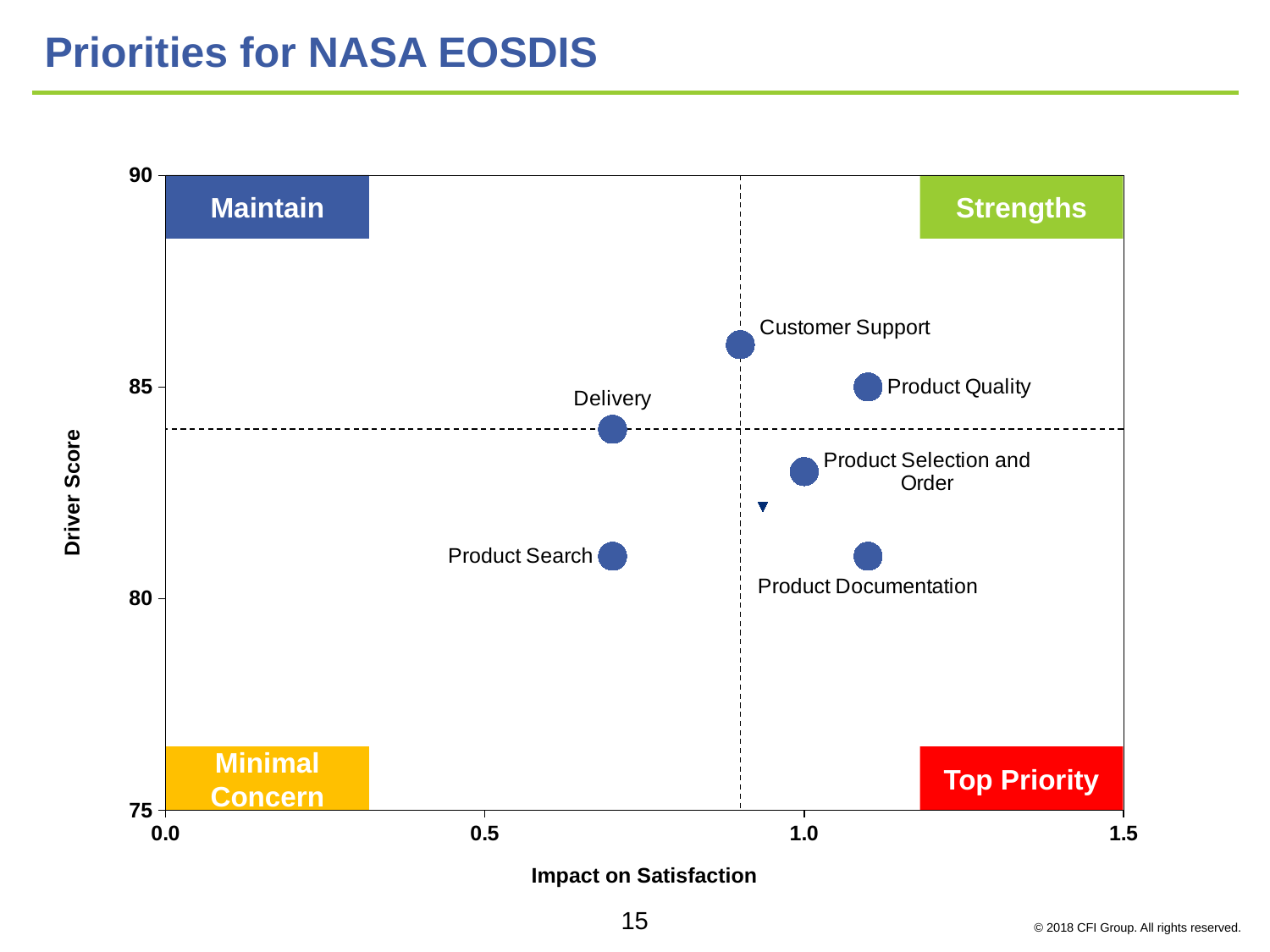
Is the Driver Score for Customer Support greater or less than 85? greater Which has a higher Impact on Satisfaction, Product Quality or Delivery? Product Quality How many labeled drivers are plotted on the chart? 6 Is the Driver Score for Product Search greater or less than 85? less What is the label on the x axis of the chart? Impact on Satisfaction What is the Driver Score for Product Quality? 85 Which has a higher Driver Score, Customer Support or Delivery? Customer Support What kind of chart is shown on the slide? Scatter chart Is the Impact on Satisfaction for Delivery greater or less than 1.0? less Which driver has the highest Driver Score? Customer Support What is the label of the quadrant in the bottom right corner of the chart? Top Priority